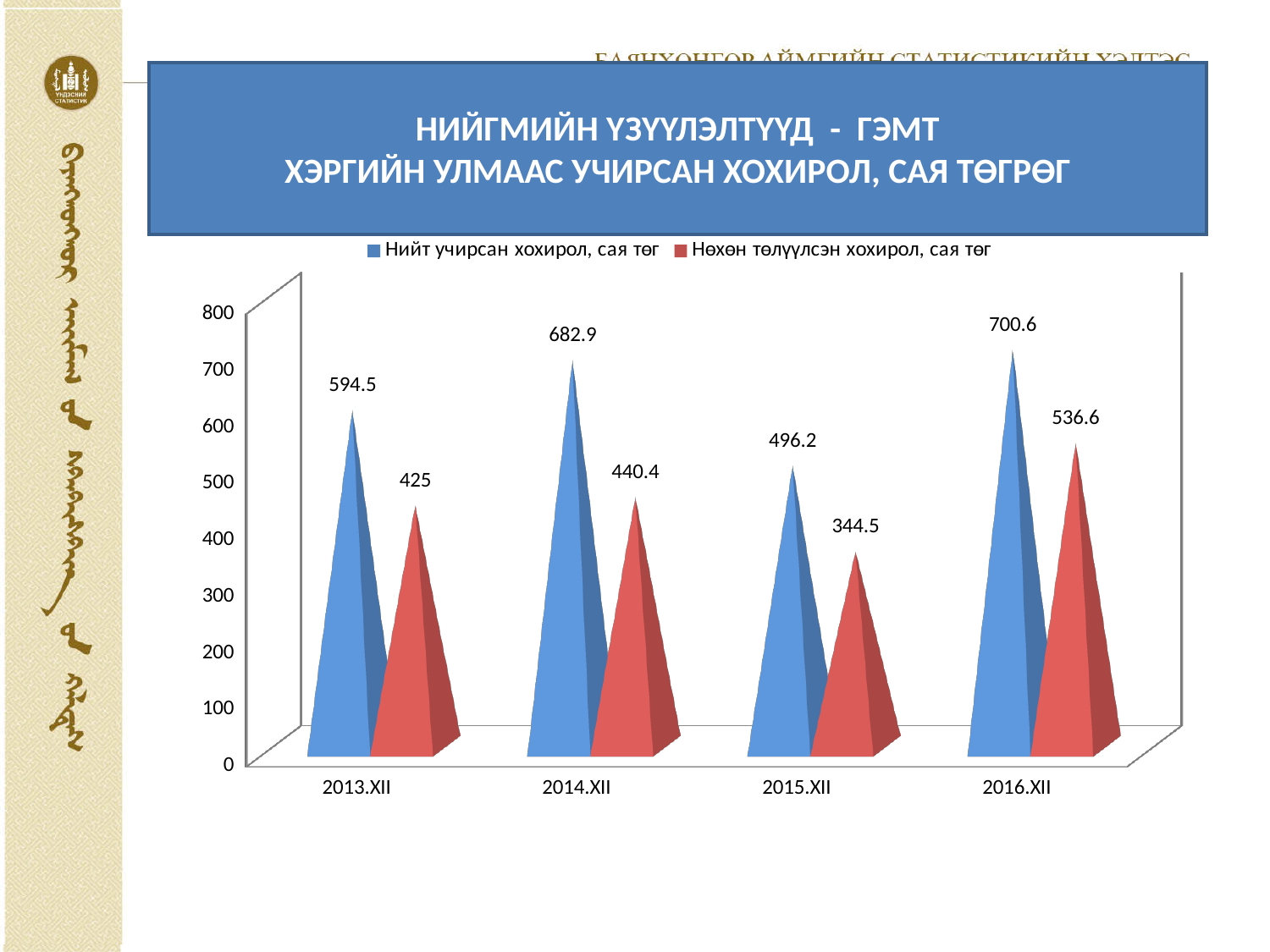
What is the value of "Нийт учирсан хохирол, сая төг" for 2014.XII? 682.9 How many series does the legend list? 2 In which period is "Нөхөн төлүүлсэн хохирол, сая төг" lowest? 2015.XII Is the value of "Нөхөн төлүүлсэн хохирол, сая төг" for 2014.XII greater or less than 500? less What is the value of "Нөхөн төлүүлсэн хохирол, сая төг" for 2013.XII? 425 In which period is "Нийт учирсан хохирол, сая төг" highest? 2016.XII What is the difference between "Нийт учирсан хохирол, сая төг" and "Нөхөн төлүүлсэн хохирол, сая төг" in 2015.XII? 151.7 What is the value of "Нөхөн төлүүлсэн хохирол, сая төг" for 2016.XII? 536.6 Which colour represents "Нөхөн төлүүлсэн хохирол, сая төг" in the chart? red How many periods are shown on the x axis? 4 What kind of chart is shown on the slide? bar chart Which is larger: "Нийт учирсан хохирол, сая төг" in 2013.XII or in 2015.XII? 2013.XII